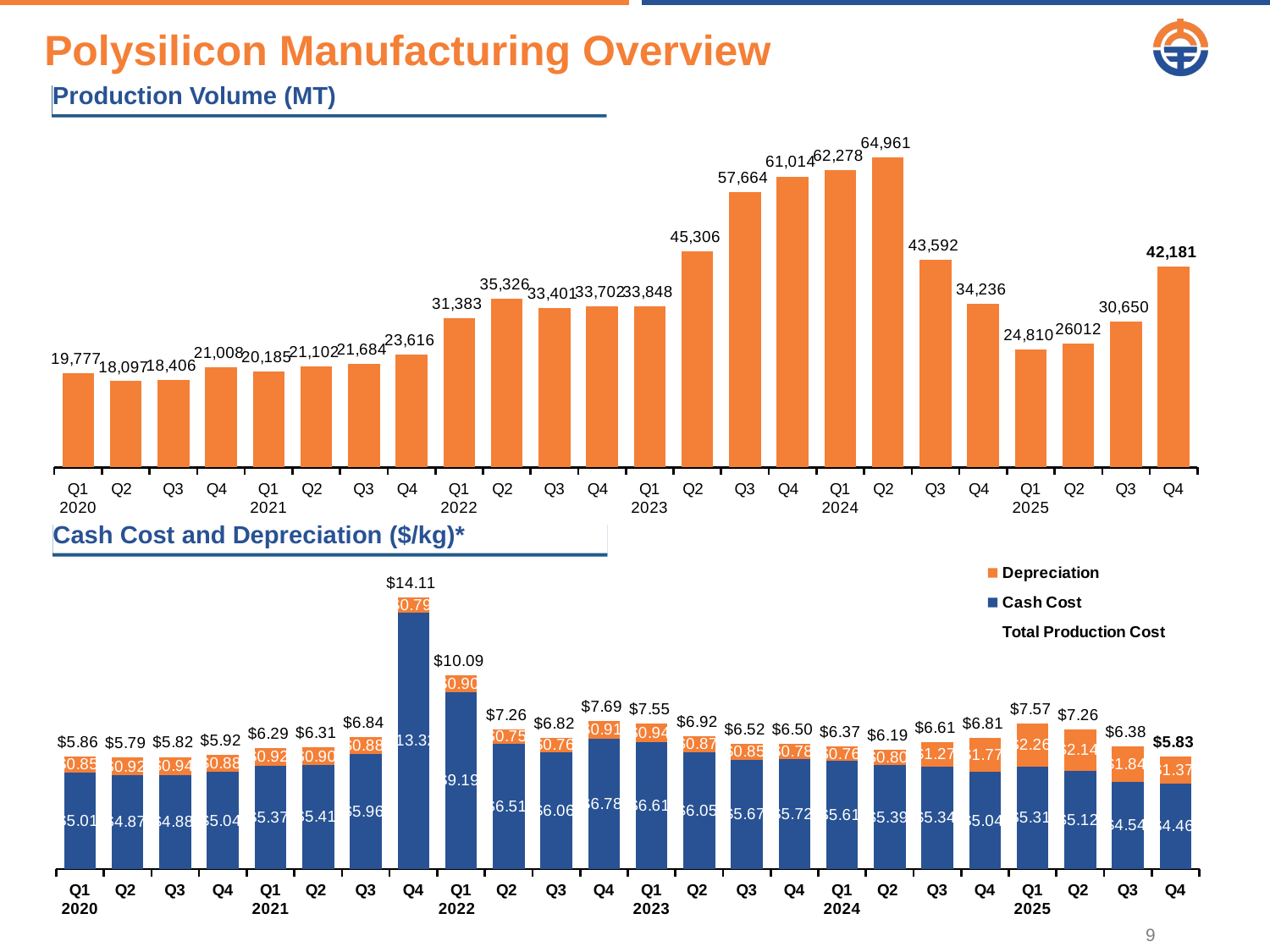
In the Cash Cost and Depreciation ($/kg) chart, which quarter had the highest total production cost? Q4 2021 In the Production Volume (MT) chart, which quarter had the lowest production volume? Q2 2020 What type of chart is the Production Volume (MT) chart? Bar chart In the Production Volume (MT) chart, what was the production volume in Q2 2024? 64,961 In the Cash Cost and Depreciation ($/kg) chart, how many series does the legend list as stacked bar components? 2 In the Cash Cost and Depreciation ($/kg) chart, what was the total production cost in Q4 2021? $14.11 In the Production Volume (MT) chart, how many quarters are plotted? 24 In the Production Volume (MT) chart, what was the production volume in Q4 2025? 42,181 In the Production Volume (MT) chart, which quarter had the highest production volume? Q2 2024 In the Cash Cost and Depreciation ($/kg) chart, which is larger: the total production cost in Q1 2025 or in Q3 2025? Q1 2025 In the Production Volume (MT) chart, what is the difference between the production volume in Q3 2023 and Q2 2023? 12,358 In the Cash Cost and Depreciation ($/kg) chart, what was the cash cost in Q4 2025? $4.46